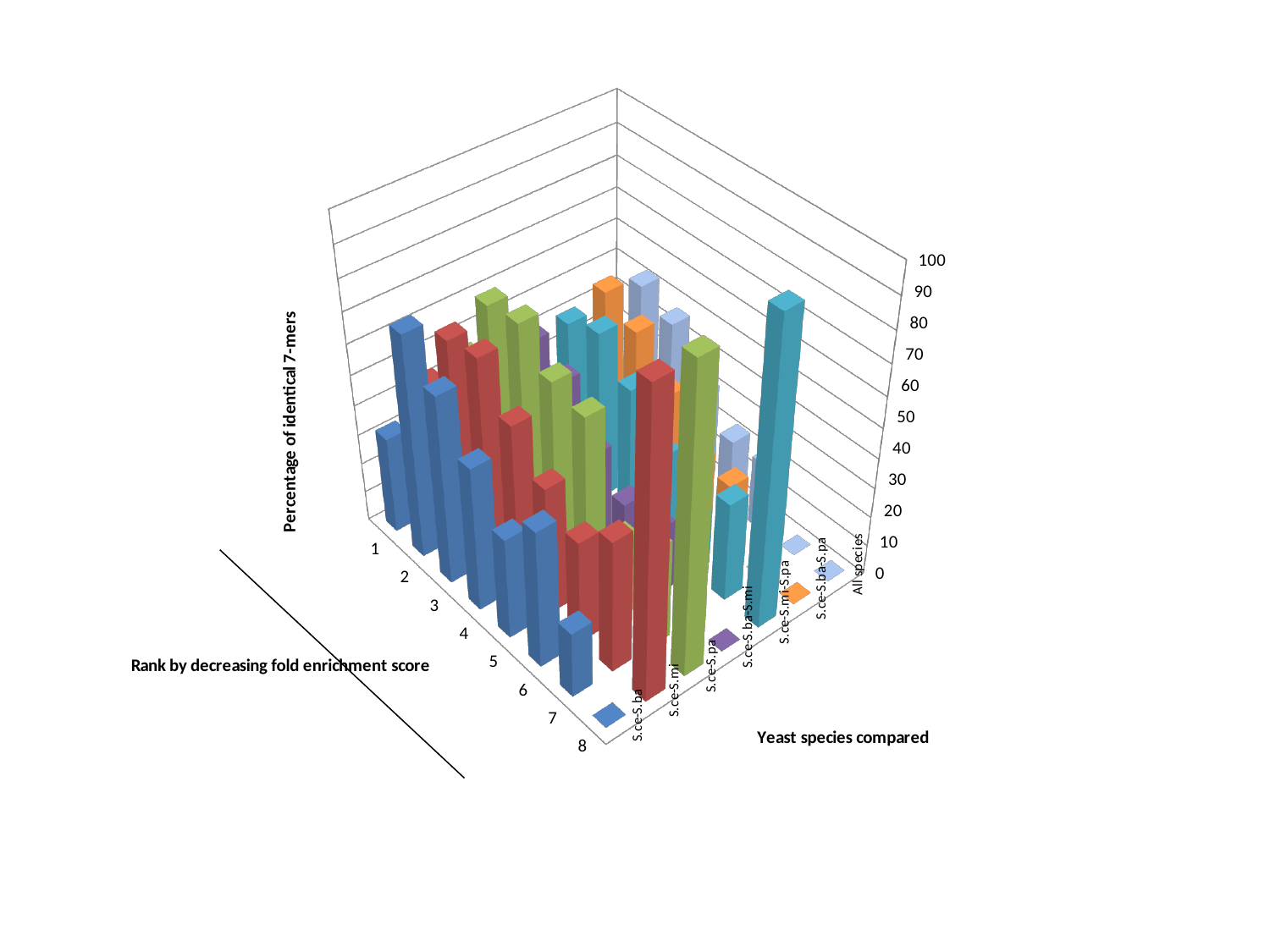
For the S.ce-S.ba series, do the bars generally rise or fall as the rank goes from 1 to 8? fall What kind of chart is shown on the slide? bar chart What is the title of the vertical axis? Percentage of identical 7-mers How many series does the legend list? 7 How many rank categories are shown along the 'Rank by decreasing fold enrichment score' axis? 8 Which series is listed first in the legend? S.ce-S.ba